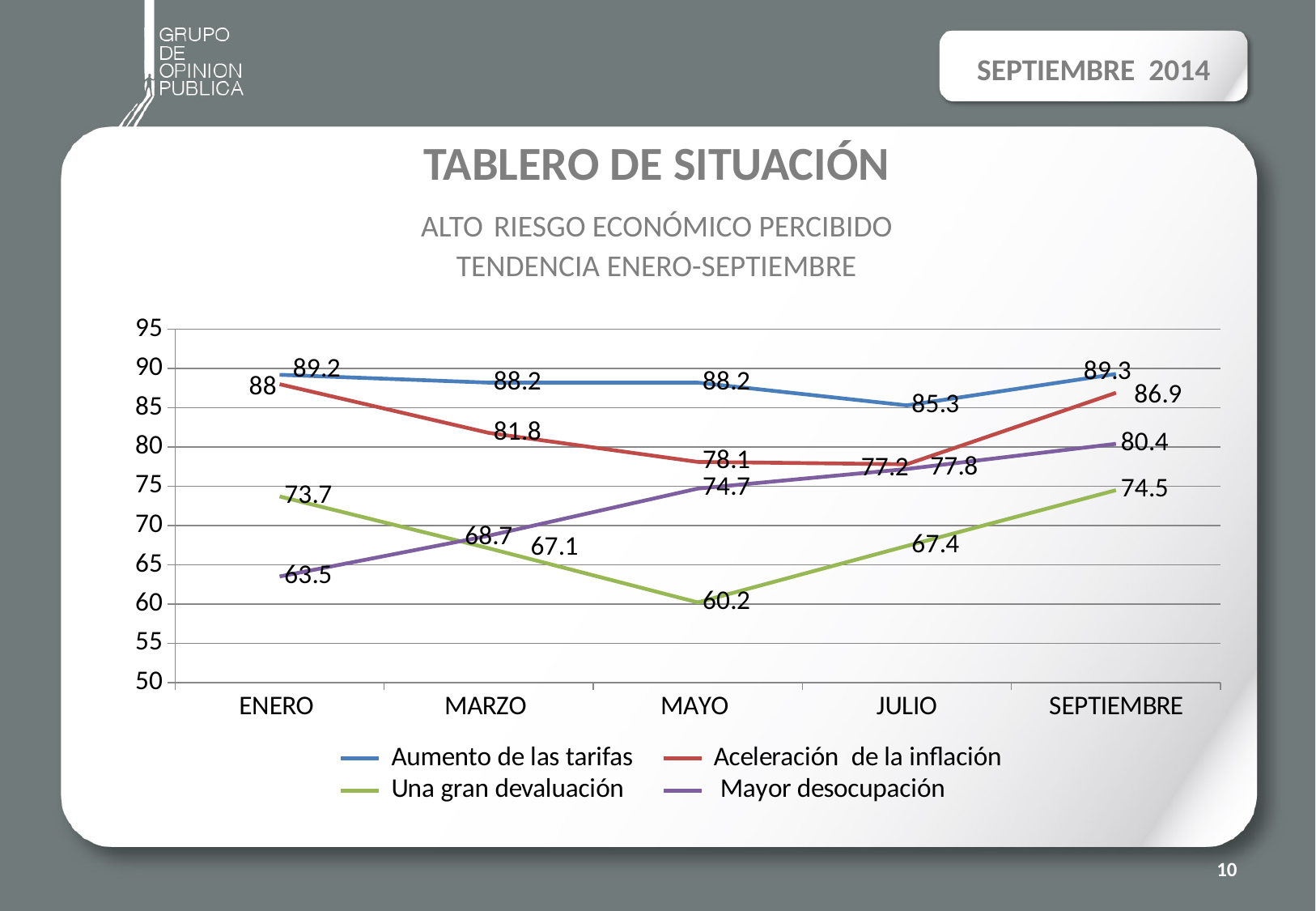
How many months are shown on the x axis? 5 In which month is Una gran devaluación lowest? MAYO Does Mayor desocupación rise or fall from ENERO to SEPTIEMBRE? rise What is the value for Mayor desocupación in SEPTIEMBRE? 80.4 What is the difference between Aceleración de la inflación in SEPTIEMBRE and in JULIO? 9.1 Which is larger in ENERO: Una gran devaluación or Mayor desocupación? Una gran devaluación What is the value for Aceleración de la inflación in MARZO? 81.8 What is the value for Una gran devaluación in MAYO? 60.2 What is the value for Aumento de las tarifas in JULIO? 85.3 What type of chart is shown on the slide? line chart In which month is Aumento de las tarifas highest? SEPTIEMBRE How many series does the legend list? 4